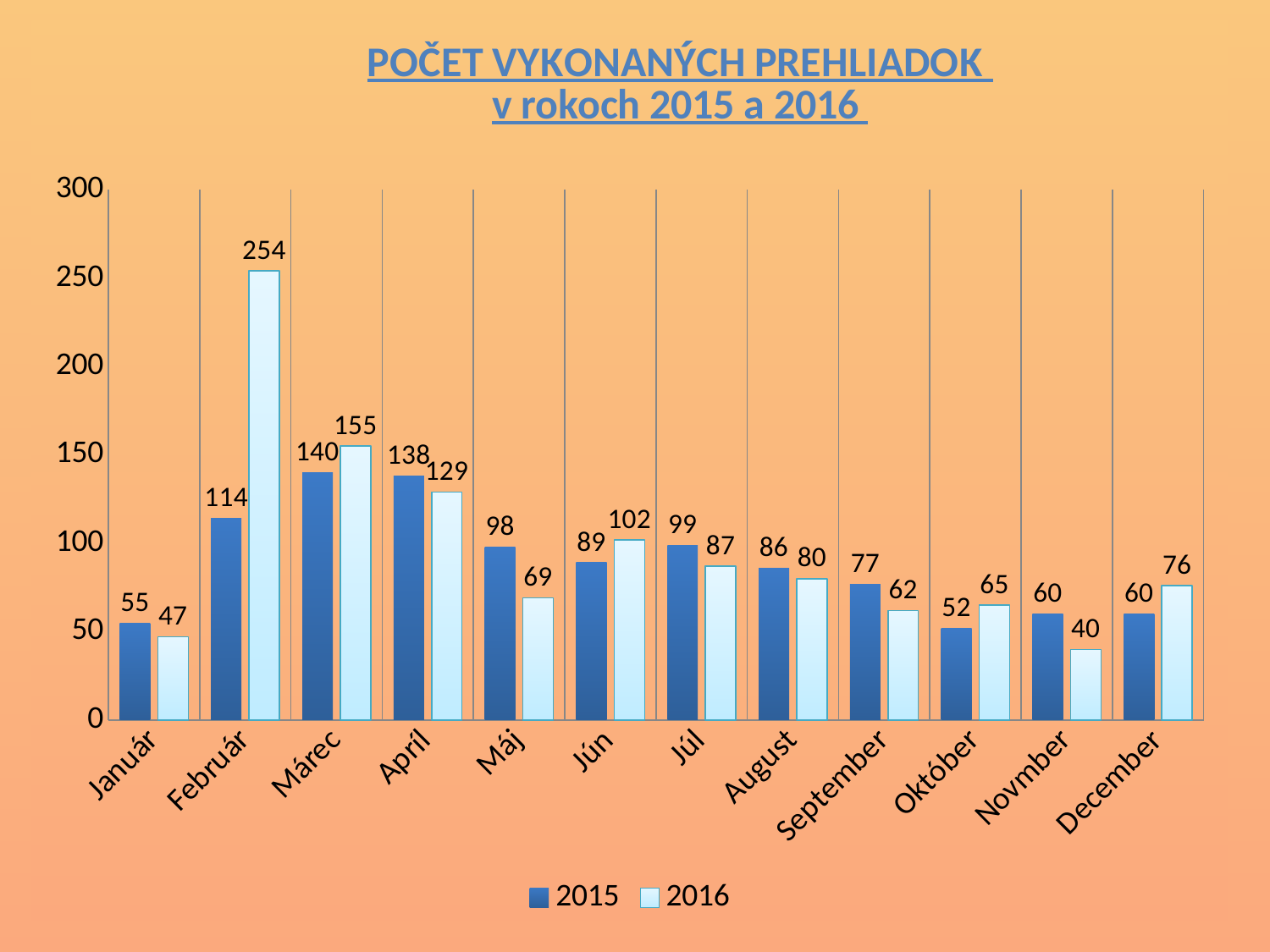
What is the total of the 2015 and 2016 values for Január? 102 What is the value for Novmber in the 2016 series? 40 Which series is shown in dark blue in the legend? 2015 What is the value for Máj in the 2015 series? 98 What is the value for Február in the 2016 series? 254 What kind of chart is shown on the slide? Bar chart Which is larger for Apríl: the 2015 value or the 2016 value? 2015 Which month has the highest value in the 2016 series? Február Which month has the lowest value in the 2015 series? Október How many months are shown on the x axis? 12 How many series does the legend list? 2 What is the difference between the 2016 and 2015 values for Február? 140